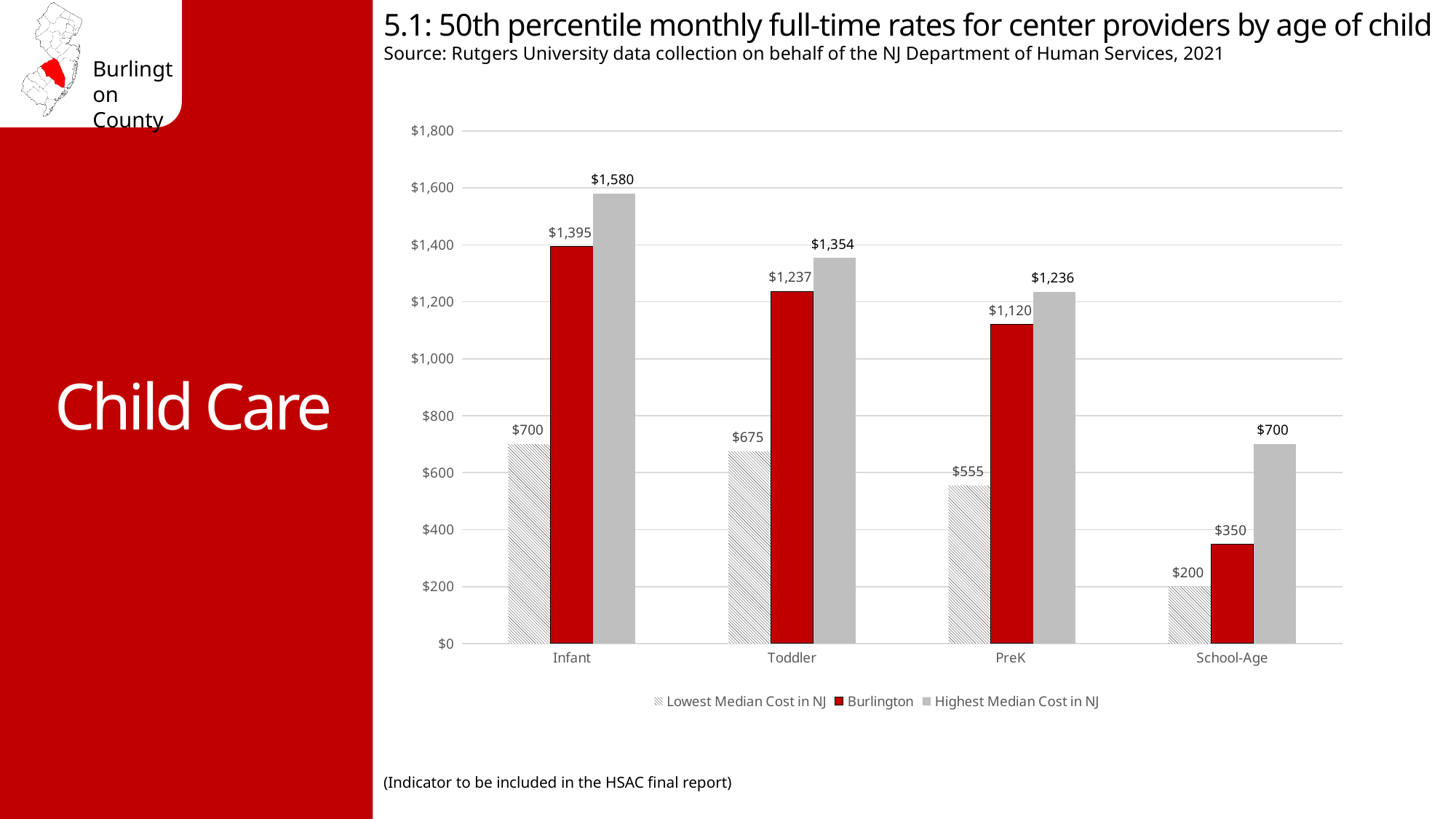
What is the difference between the Highest Median Cost in NJ and the Burlington value for Infant? $185 How many age groups are shown on the x axis? 4 What kind of chart is shown on the slide? Bar chart Which is larger: the Burlington value for PreK or the Burlington value for Toddler? Toddler What is the Lowest Median Cost in NJ for PreK? $555 Which age group has the lowest Highest Median Cost in NJ? School-Age What is the Highest Median Cost in NJ for Toddler? $1,354 What is the Burlington value for School-Age? $350 Which age group has the highest Burlington value? Infant What is the difference between the Burlington value and the Lowest Median Cost in NJ for Toddler? $562 What is the Burlington value for Infant? $1,395 How many series does the legend list? 3